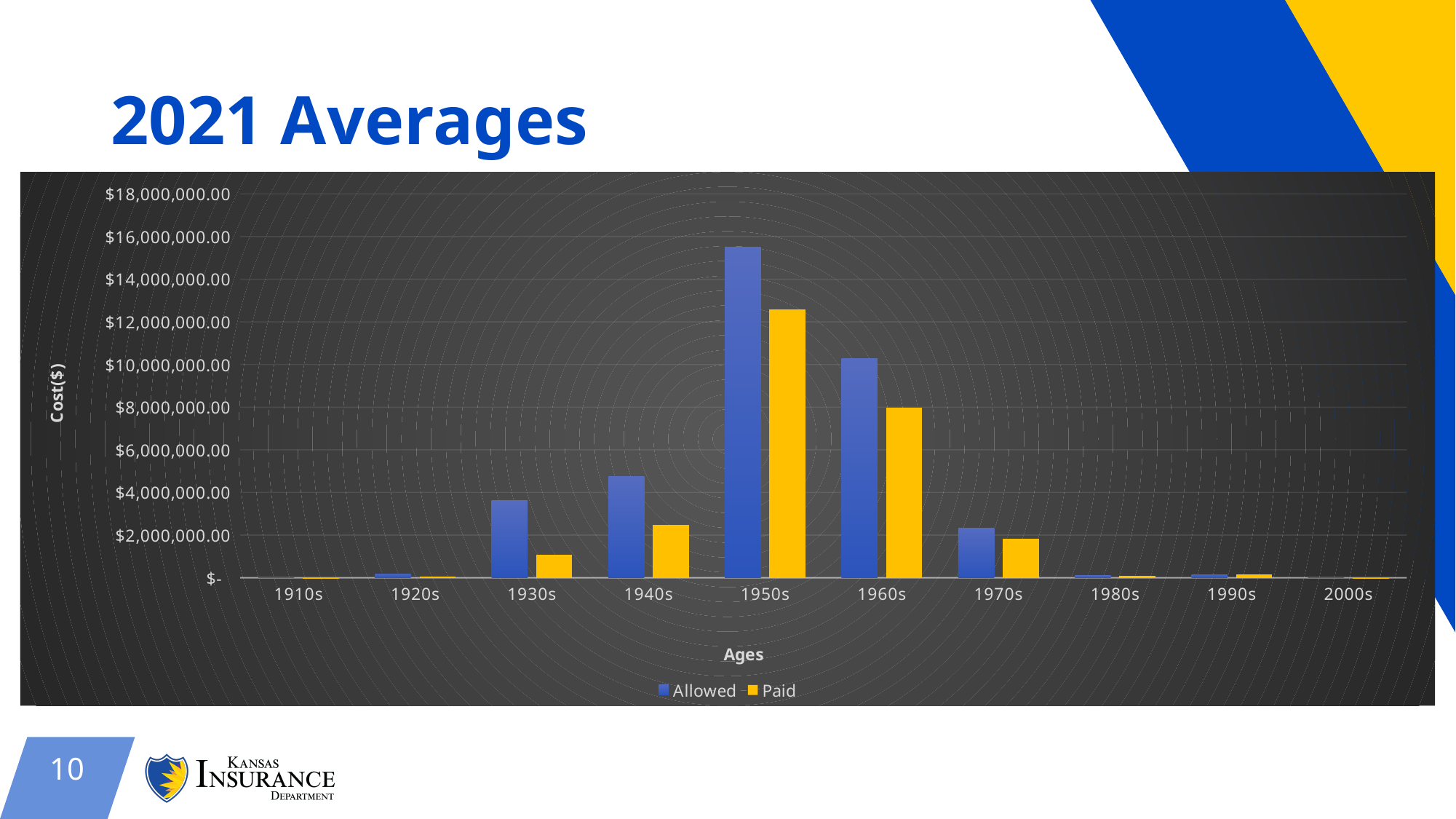
What is the label of the vertical axis? Cost($) How many series does the legend list? 2 Is the Paid value for 1930s greater or less than $2,000,000.00? less Is the Paid value for 1950s greater or less than $12,000,000.00? greater Is the Allowed value for 1950s greater or less than $14,000,000.00? greater Which age category has the highest Paid value? 1950s For the 1950s, which is larger, the Allowed value or the Paid value? Allowed Which age category has the highest Allowed value? 1950s What kind of chart is shown on the slide? bar chart How many age categories are shown on the x axis? 10